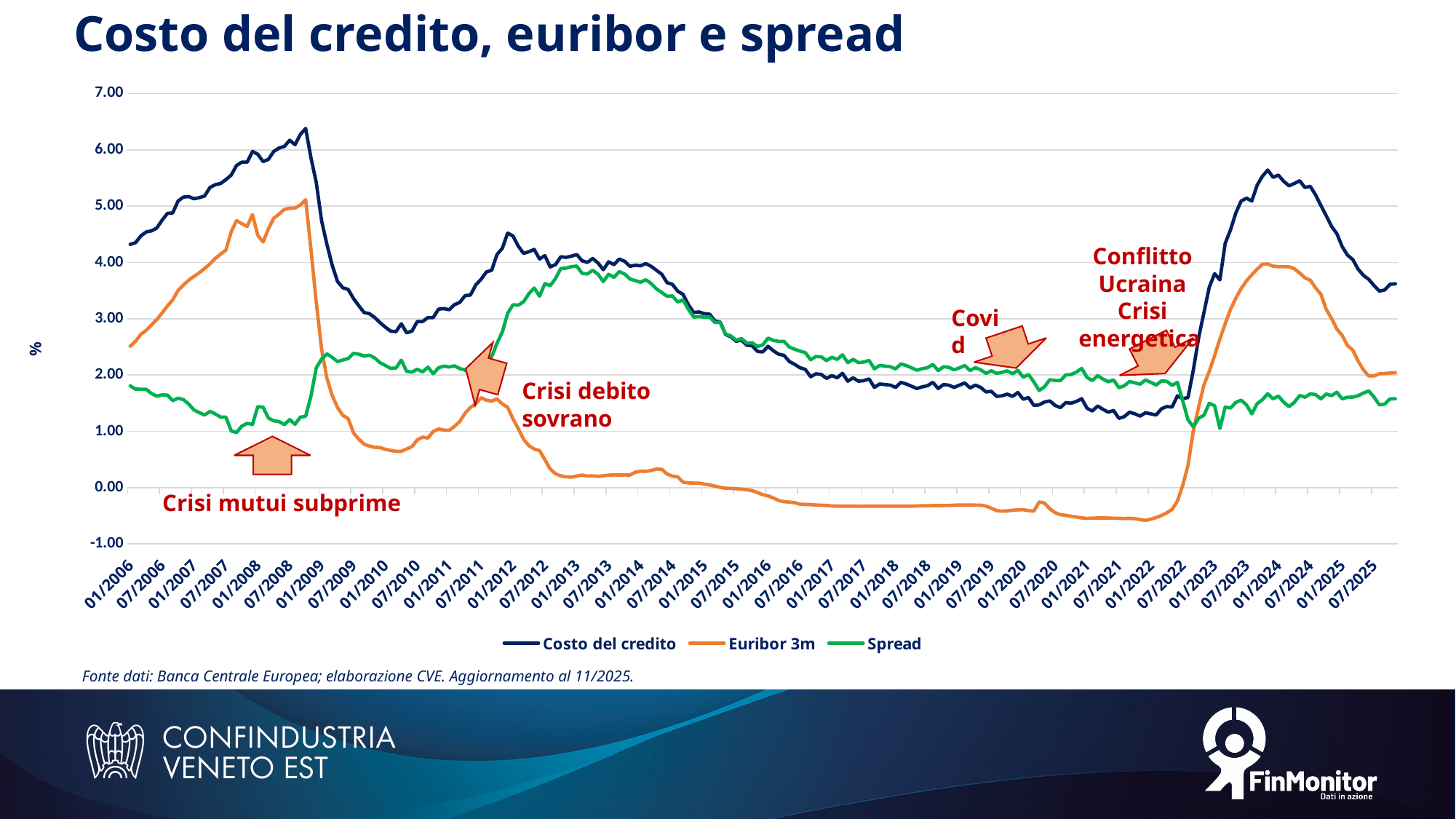
Is the value of Spread at 01/2013 greater or less than 3.00? greater What are the three series named in the legend? Costo del credito, Euribor 3m, Spread Is the value of Costo del credito at 07/2021 greater or less than 2.00? less Is the value of Costo del credito at 01/2006 greater or less than 4.00? greater What is the title of the chart? Costo del credito, euribor e spread What kind of chart is shown on the slide? line chart How many series does the legend list? 3 Which series reaches the highest value anywhere on the chart? Costo del credito Does the Euribor 3m line rise or fall between 07/2022 and 01/2024? rise At 01/2024, which is larger: Costo del credito or Euribor 3m? Costo del credito